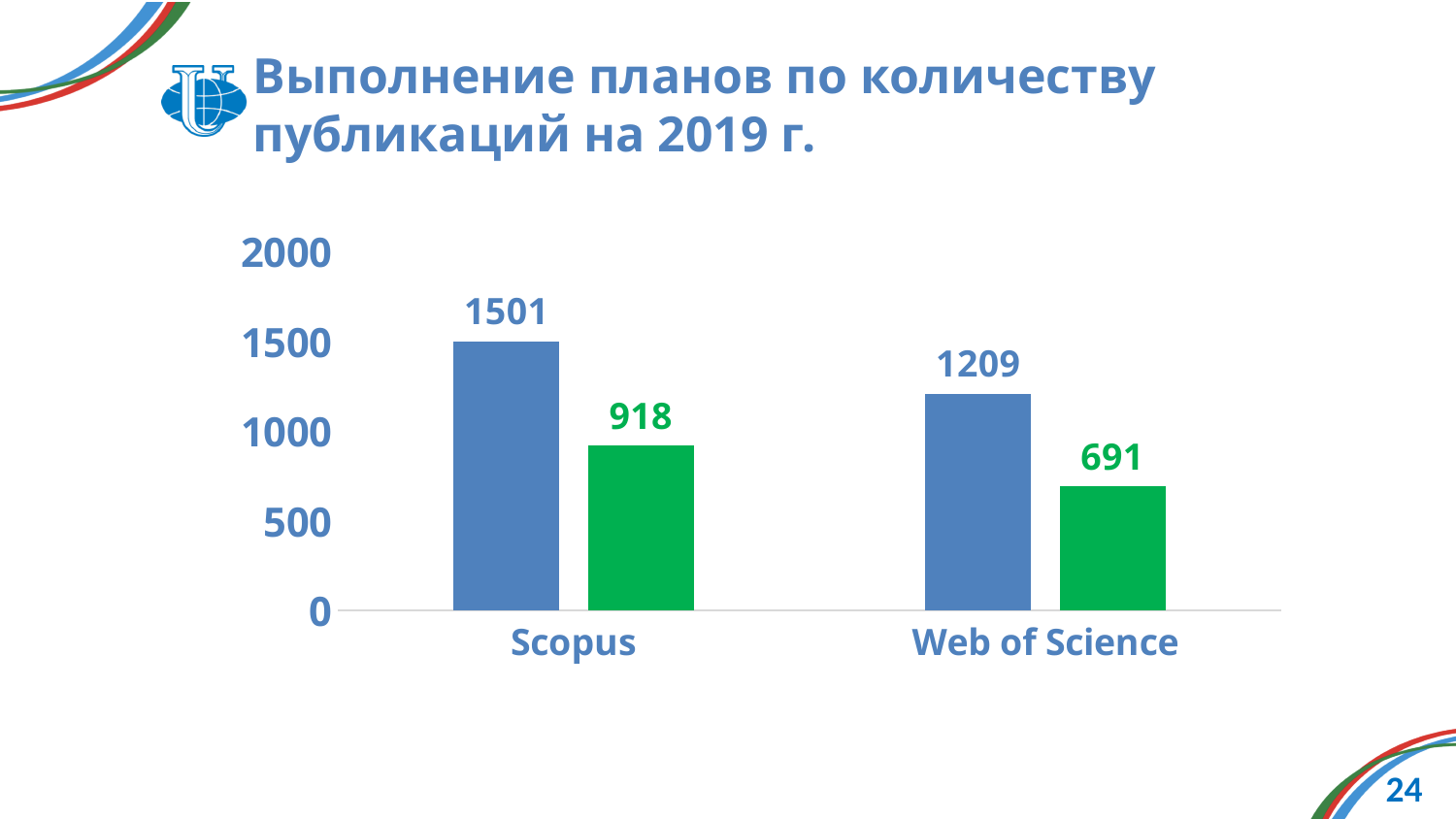
Which is larger: the green bar for Scopus or the green bar for Web of Science? The green bar for Scopus What is the difference between the blue and green bars for Scopus? 583 What is the value of the green bar for Web of Science? 691 Which bar on the chart has the highest value? The blue bar for Scopus (1501) What is the value of the blue bar for Web of Science? 1209 What is the difference between the blue bars for Scopus and Web of Science? 292 What is the value of the green bar for Scopus? 918 What type of chart is shown on the slide? Bar chart How many categories are shown on the x axis? 2 Which bar on the chart has the lowest value? The green bar for Web of Science (691) Is the value of the blue bar for Web of Science greater or less than 1000? greater What is the value of the blue bar for Scopus? 1501